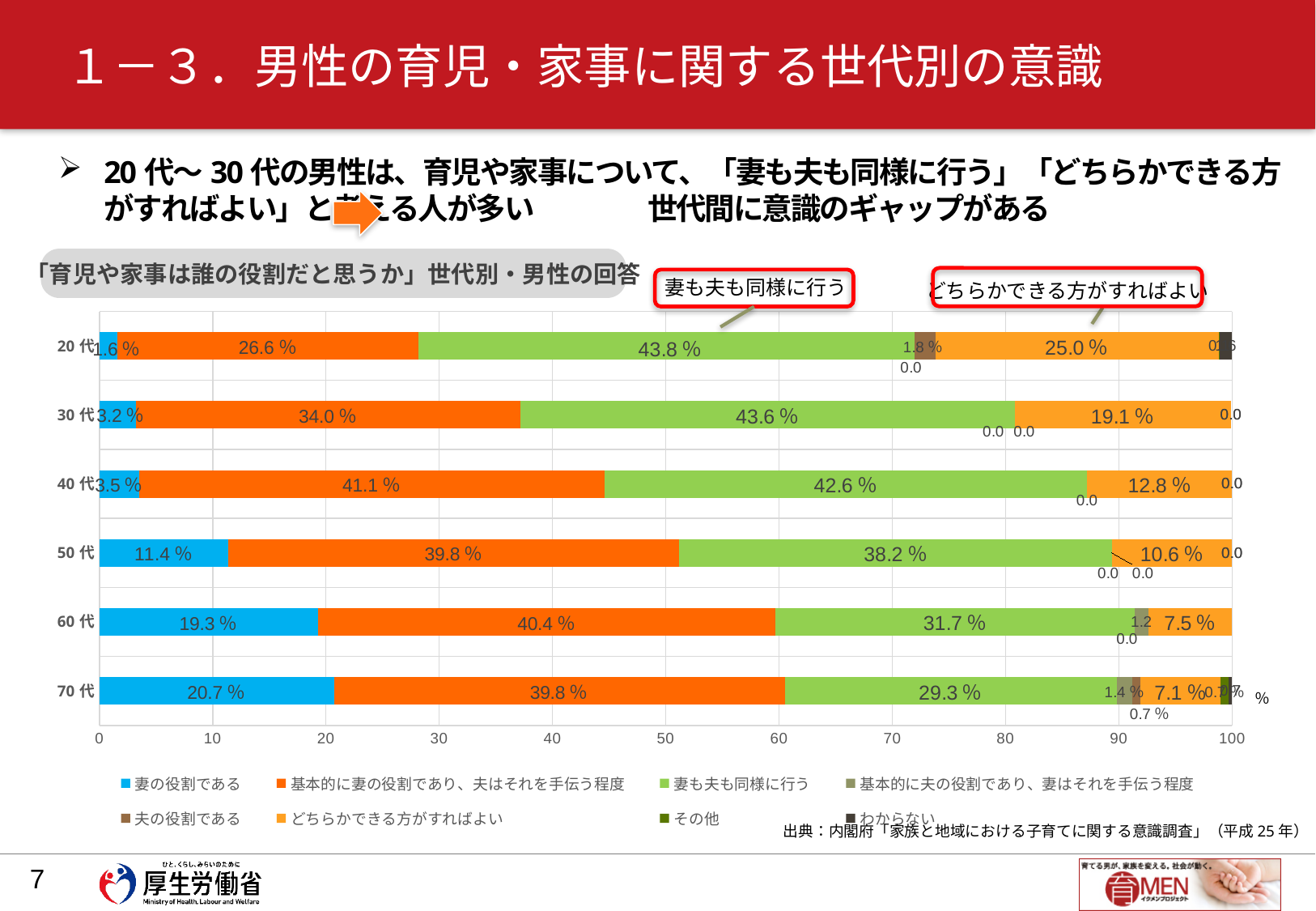
What is the value of どちらかできる方がすればよい for 20代? 25.0 % What is the value of 基本的に妻の役割であり、夫はそれを手伝う程度 for 50代? 39.8 % What kind of chart is shown on the slide? Stacked bar chart Which age group has the highest value for 妻の役割である? 70代 Which age group has the highest value for どちらかできる方がすればよい? 20代 Which age group has the lowest value for 妻も夫も同様に行う? 70代 What is the difference between the 妻の役割である values for 70代 and 20代? 19.1 % How many age groups are shown in the chart? 6 What is the value of 妻の役割である for 70代? 20.7 % What is the value of 妻も夫も同様に行う for 30代? 43.6 % How many series does the legend list? 8 Which is larger, the 基本的に妻の役割であり、夫はそれを手伝う程度 value for 40代 or for 60代? 40代